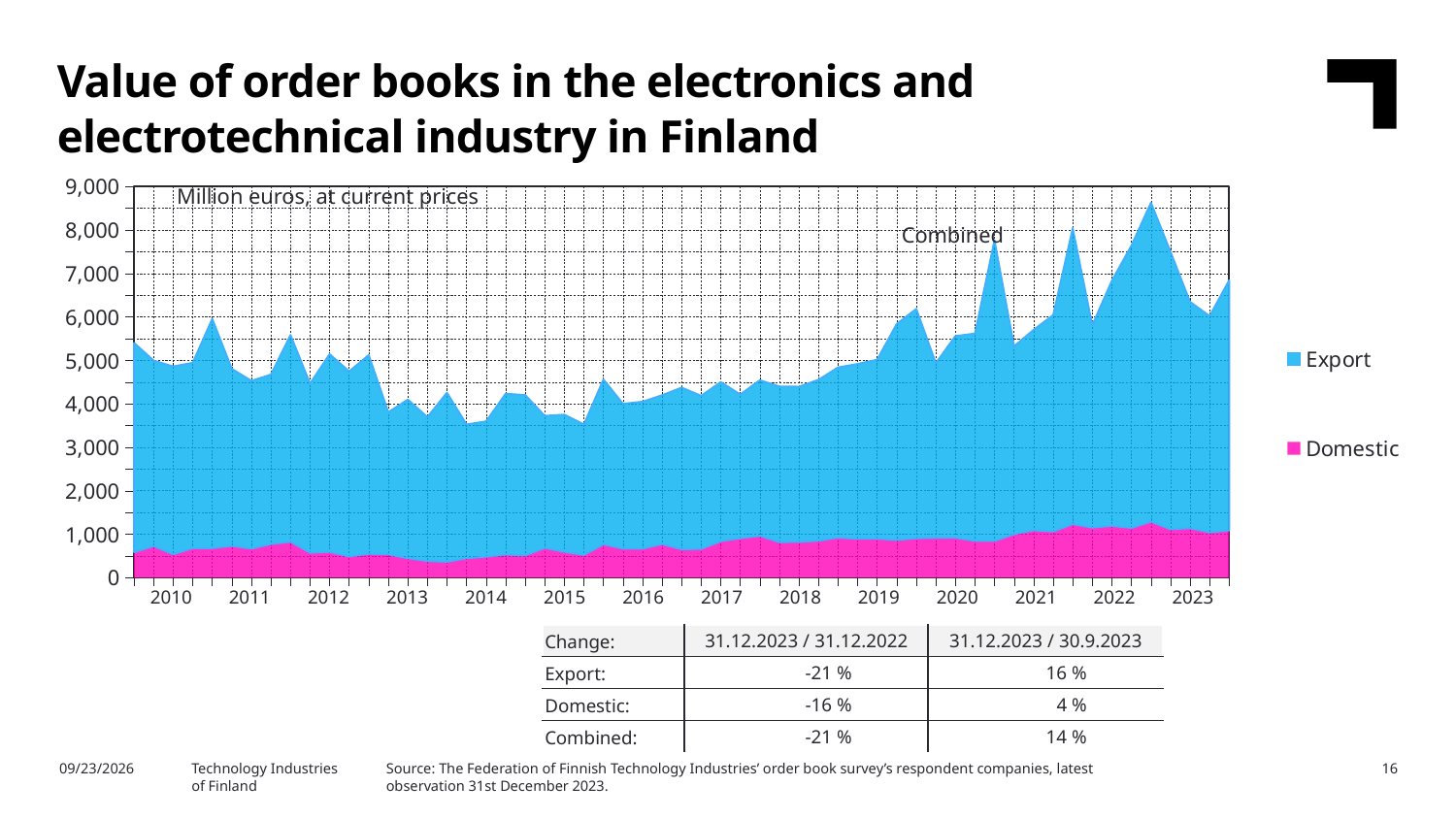
In which year does the combined order book value reach its highest peak? 2022 What are the two series named in the chart's legend? Export and Domestic How many series does the chart's legend list? 2 What unit label is printed inside the chart area? Million euros, at current prices Is the Domestic value in 2010 greater or less than 1,000? less What kind of chart is shown on the slide? Stacked area chart Is the combined peak value in 2022 greater or less than 8,000? greater Is the combined value in 2015 greater or less than 5,000? less How many years are labelled on the x axis of the chart? 14 Which series is larger throughout the chart, Export or Domestic? Export Does the Domestic series generally rise or fall from 2010 to 2023? Rise